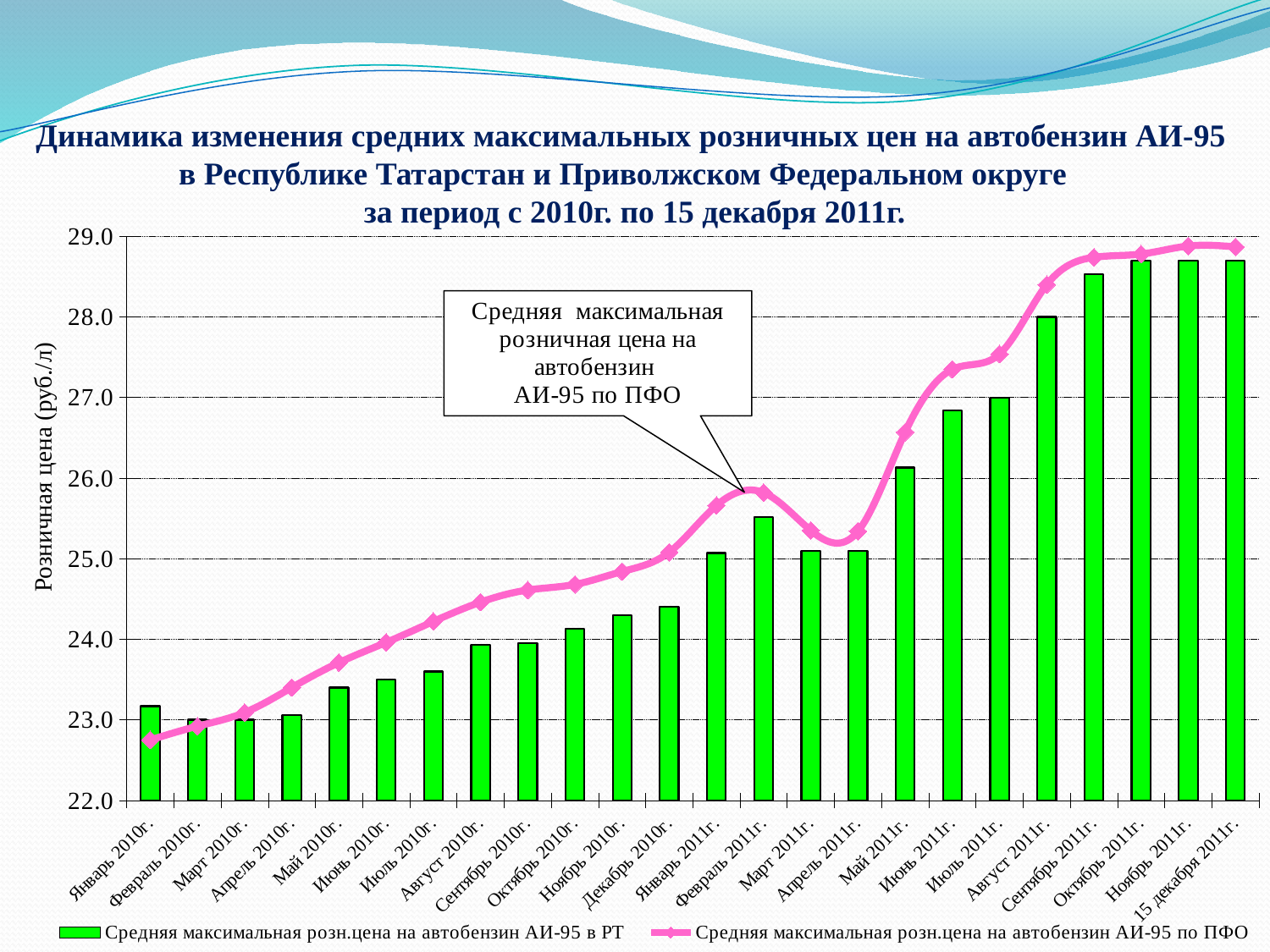
Is the line value for Январь 2010г. (price in ПФО) greater or less than 23.0? less Is the bar value for Май 2011г. (price in РТ) greater or less than 26.0? greater What is the label of the y axis? Розничная цена (руб./л) Which series is drawn as a pink line with markers? Средняя максимальная розн.цена на автобензин АИ-95 по ПФО What kind of chart is shown on the slide? A combined bar and line chart How many series does the legend list? 2 How many time periods (categories) are shown on the x axis? 24 Overall, do the retail prices rise or fall from Январь 2010г. to 15 декабря 2011г.? Rise Is the bar value for Июль 2010г. (price in РТ) greater or less than 24.0? less In Февраль 2011г., which is higher: the price in РТ (bar) or the price in ПФО (line)? The price in ПФО (line) Which is larger, the bar for Февраль 2011г. or the bar for Март 2011г.? Февраль 2011г.